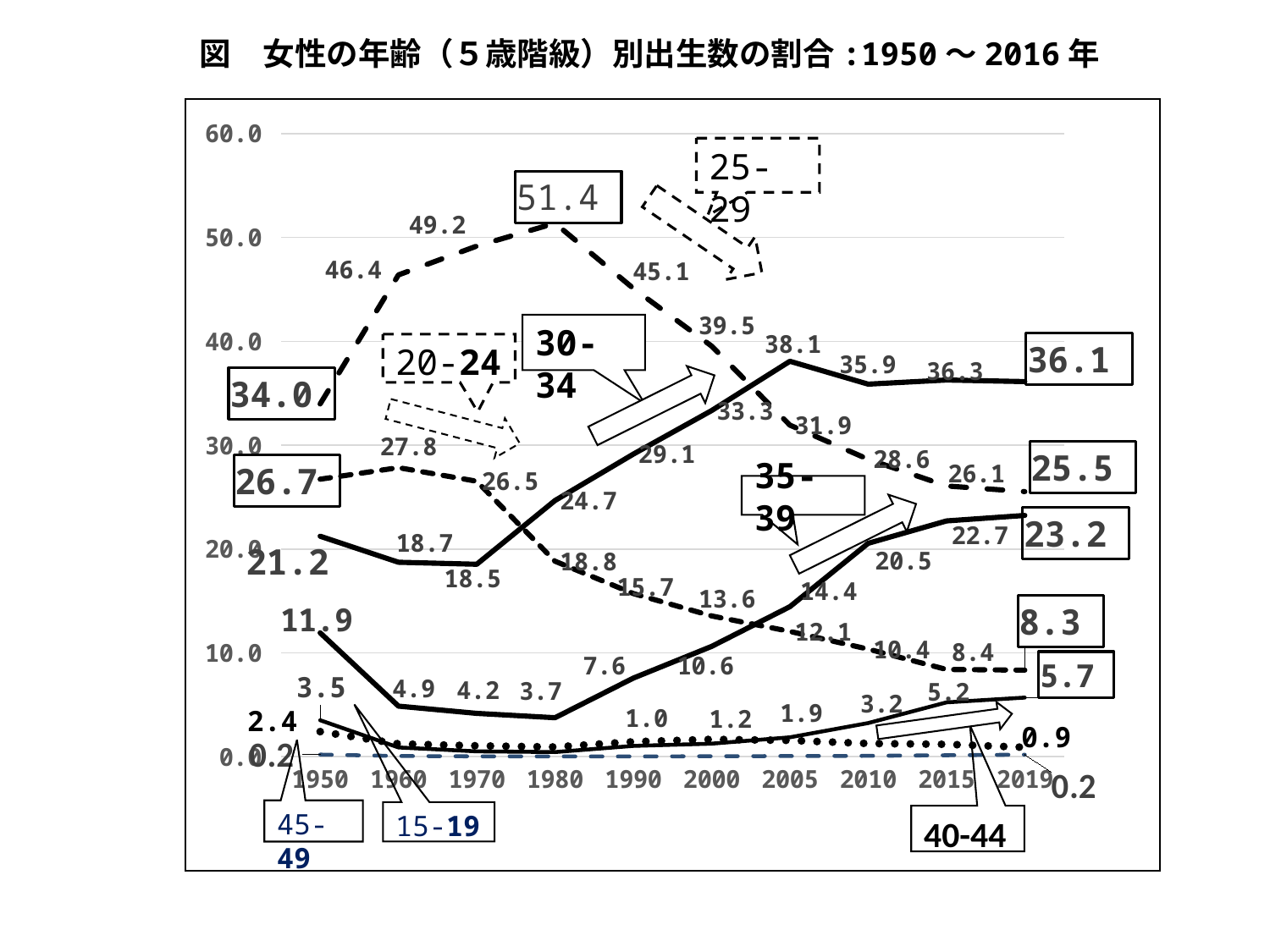
Does the 35-39 series rise or fall from 1980 to 2019? rise In 2019, which is larger: the value for 25-29 or the value for 35-39? 25-29 What kind of chart is shown on the slide? line chart Is the value for the 25-29 age group in 1980 greater or less than 50.0? greater How many years are marked along the x axis of the chart? 10 What is the value for the 30-34 age group in 2019? 36.1 Which age group has the highest value in 2019? 30-34 What is the value for the 35-39 age group in 1950? 11.9 What is the value for the 20-24 age group in 2019? 8.3 What is the difference between the 25-29 value in 1980 (51.4) and in 2019 (25.5)? 25.9 How many age-group series are labelled on the chart? 7 What is the value for the 25-29 age group in 1980? 51.4